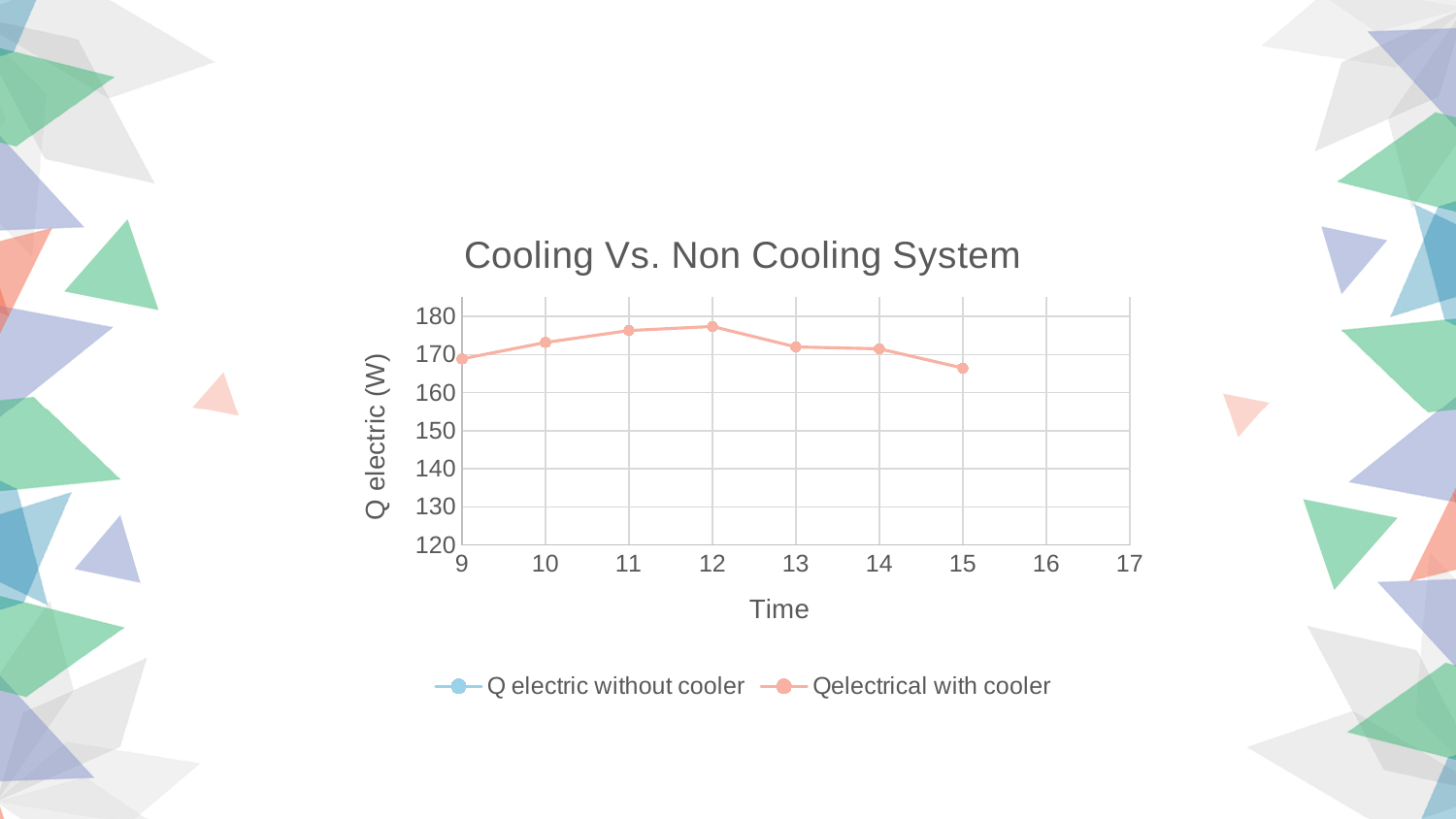
Is the value for Qelectrical with cooler at time 9 greater or less than 160? greater At which time is the Qelectrical with cooler value lowest? 15 Is the value for Qelectrical with cooler at time 11 greater or less than 180? less What is the label of the y axis? Q electric (W) What is the title of the chart? Cooling Vs. Non Cooling System How many series does the legend list? 2 Is the value for Qelectrical with cooler at time 15 greater or less than 170? less What kind of chart is shown on the slide? line chart Does the Qelectrical with cooler line rise or fall between time 12 and time 15? fall Which is larger for Qelectrical with cooler: the value at time 12 or at time 15? time 12 How many data points are plotted on the Qelectrical with cooler line? 7